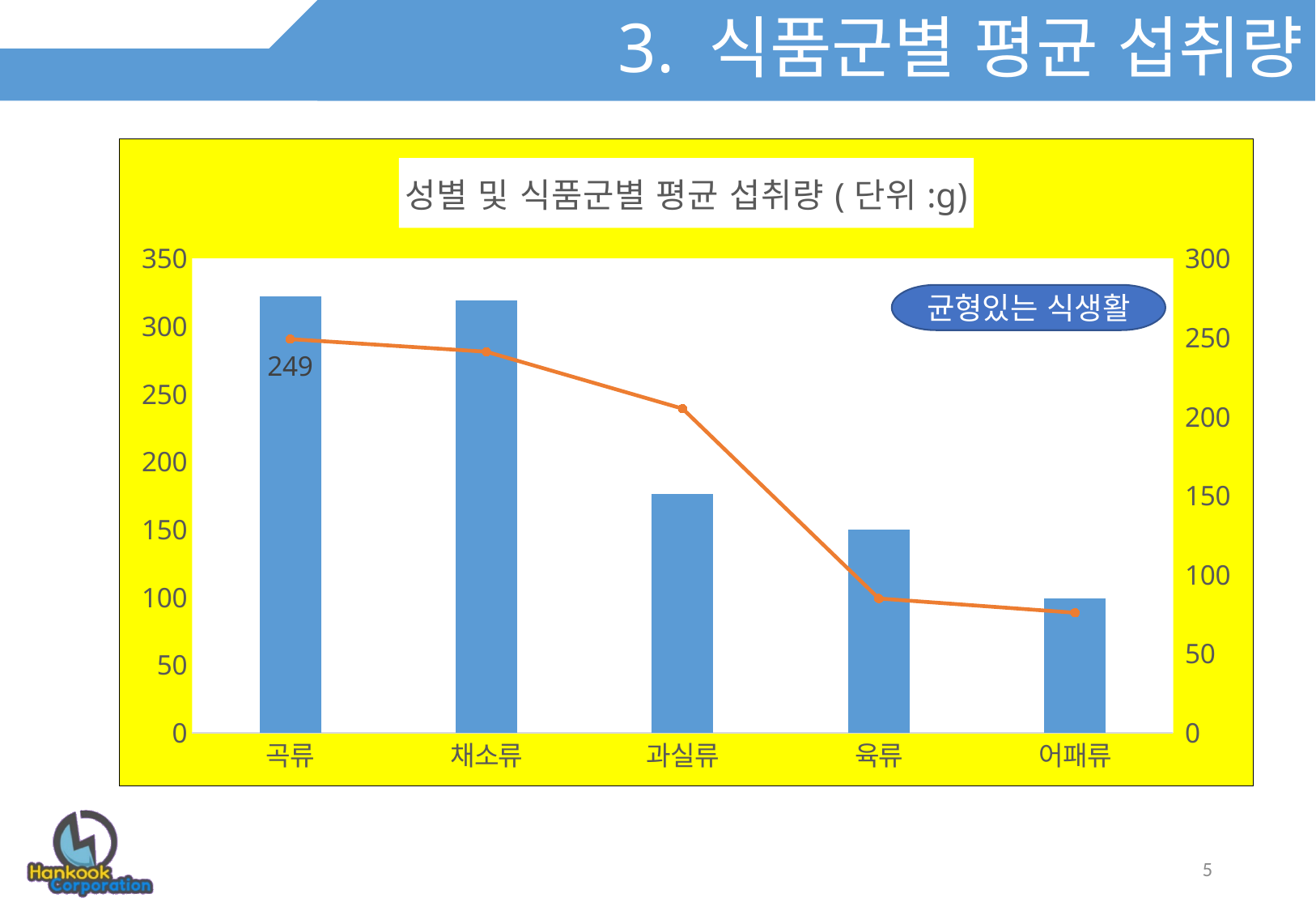
Is the bar value for 과실류 greater or less than 150 on the left axis? greater Does the orange line rise or fall from 곡류 to 어패류? It falls What text appears in the blue oval callout inside the chart? 균형있는 식생활 Which has the taller bar, 채소류 or 과실류? 채소류 How many food-group categories are shown on the x axis? 5 What is the title of the chart? 성별 및 식품군별 평균 섭취량 ( 단위 :g) What is the value printed as a data label on the line at 곡류? 249 What kind of chart is shown on the slide? A bar chart combined with a line chart Is the line value for 육류 greater or less than 100 on the right axis? less Which has the taller bar, 과실류 or 육류? 과실류 Which category has the lowest bar? 어패류 Is the bar value for 채소류 greater or less than 300 on the left axis? greater